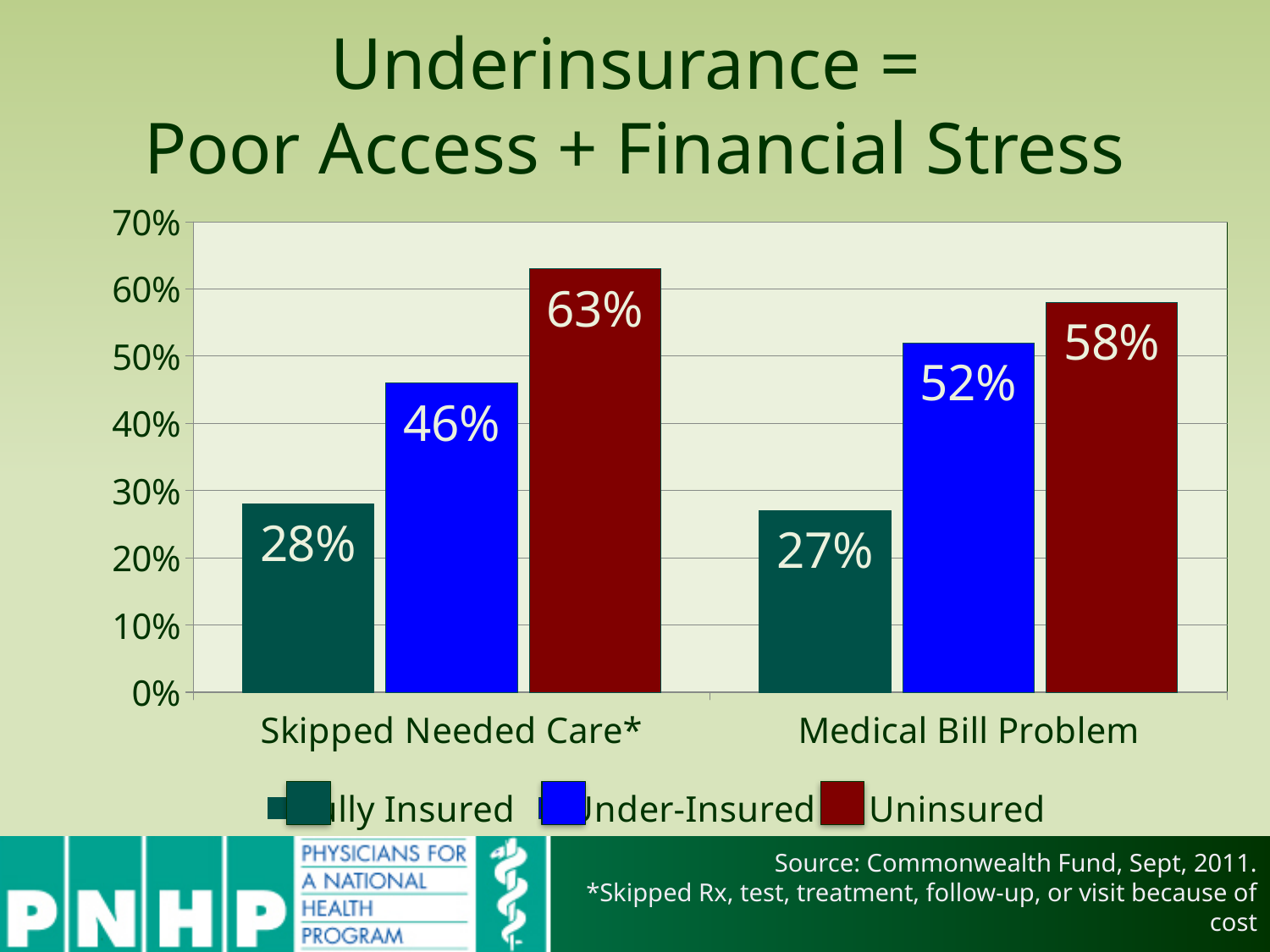
What is the value for Fully Insured in the Skipped Needed Care* category? 28% What is the difference between the Uninsured and Under-Insured values in the Skipped Needed Care* category? 17% What is the difference between the Under-Insured and Fully Insured values in the Medical Bill Problem category? 25% How many series does the legend list? 3 What kind of chart is shown on the slide? Bar chart Which is larger: the Under-Insured value for Skipped Needed Care* or the Under-Insured value for Medical Bill Problem? Medical Bill Problem Which series has the lowest value in the Medical Bill Problem category? Fully Insured What is the value for Uninsured in the Skipped Needed Care* category? 63% What is the value for Uninsured in the Medical Bill Problem category? 58% How many categories are shown on the x axis? 2 What is the value for Under-Insured in the Medical Bill Problem category? 52% Which series has the highest value in the Skipped Needed Care* category? Uninsured